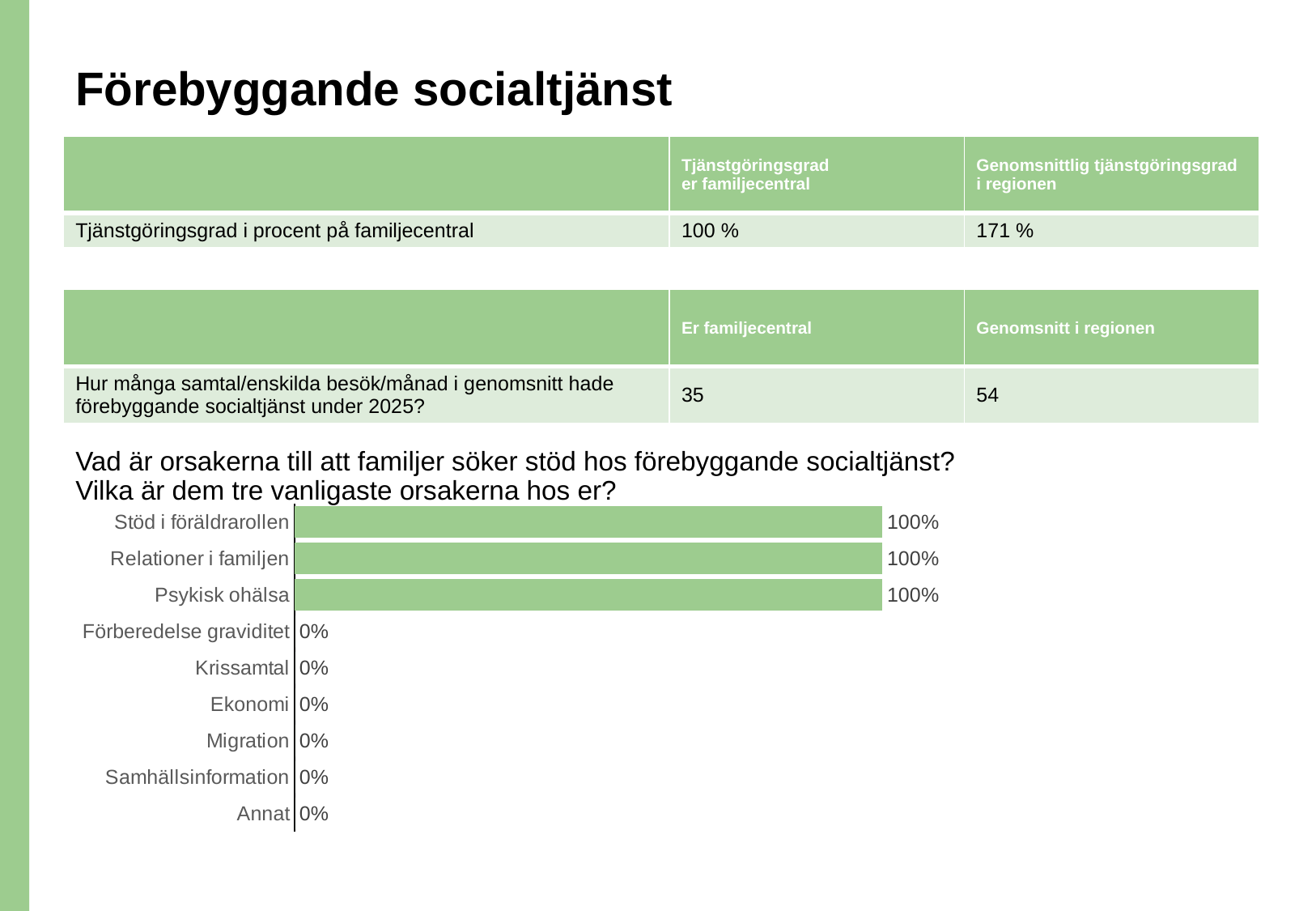
How many categories are shown in the bar chart? 9 What is the value for Psykisk ohälsa in the bar chart? 100% What is the difference between the values for Psykisk ohälsa and Migration in the bar chart? 100% Which has the larger value in the bar chart, Samhällsinformation or Relationer i familjen? Relationer i familjen What kind of chart is shown on the slide? Bar chart What is the value for Ekonomi in the bar chart? 0% How many categories in the bar chart have a value of 100%? 3 What is the value for Relationer i familjen in the bar chart? 100% Which has the larger value in the bar chart, Stöd i föräldrarollen or Krissamtal? Stöd i föräldrarollen What is the value for Annat in the bar chart? 0% What is the value for Stöd i föräldrarollen in the bar chart? 100% What is the value for Förberedelse graviditet in the bar chart? 0%